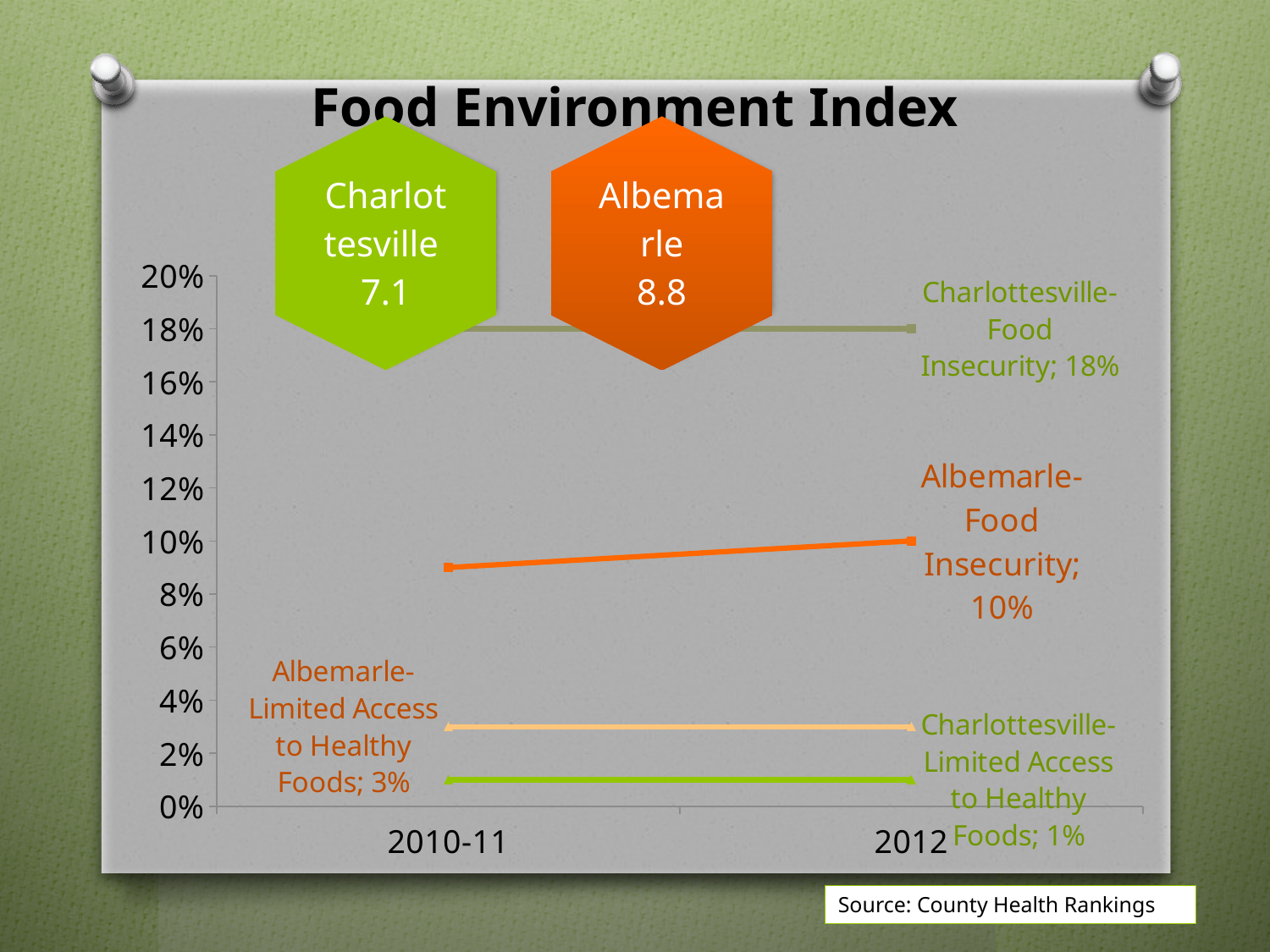
Is the value for Albemarle-Food Insecurity in 2010-11 greater or less than 8%? greater What Food Environment Index value is shown for Albemarle? 8.8 Which series has the highest value in 2012? Charlottesville-Food Insecurity What is the value for Charlottesville-Limited Access to Healthy Foods? 1% What is the value for Charlottesville-Food Insecurity in 2012? 18% What is the value for Albemarle-Food Insecurity in 2012? 10% Which is larger, Albemarle-Limited Access to Healthy Foods or Charlottesville-Limited Access to Healthy Foods? Albemarle-Limited Access to Healthy Foods What kind of chart is shown on the slide? line chart What is the difference between Charlottesville-Food Insecurity and Albemarle-Food Insecurity in 2012? 8% Does Albemarle-Food Insecurity rise or fall from 2010-11 to 2012? rise What is the value for Albemarle-Limited Access to Healthy Foods? 3% Which series has the lowest value in 2012? Charlottesville-Limited Access to Healthy Foods